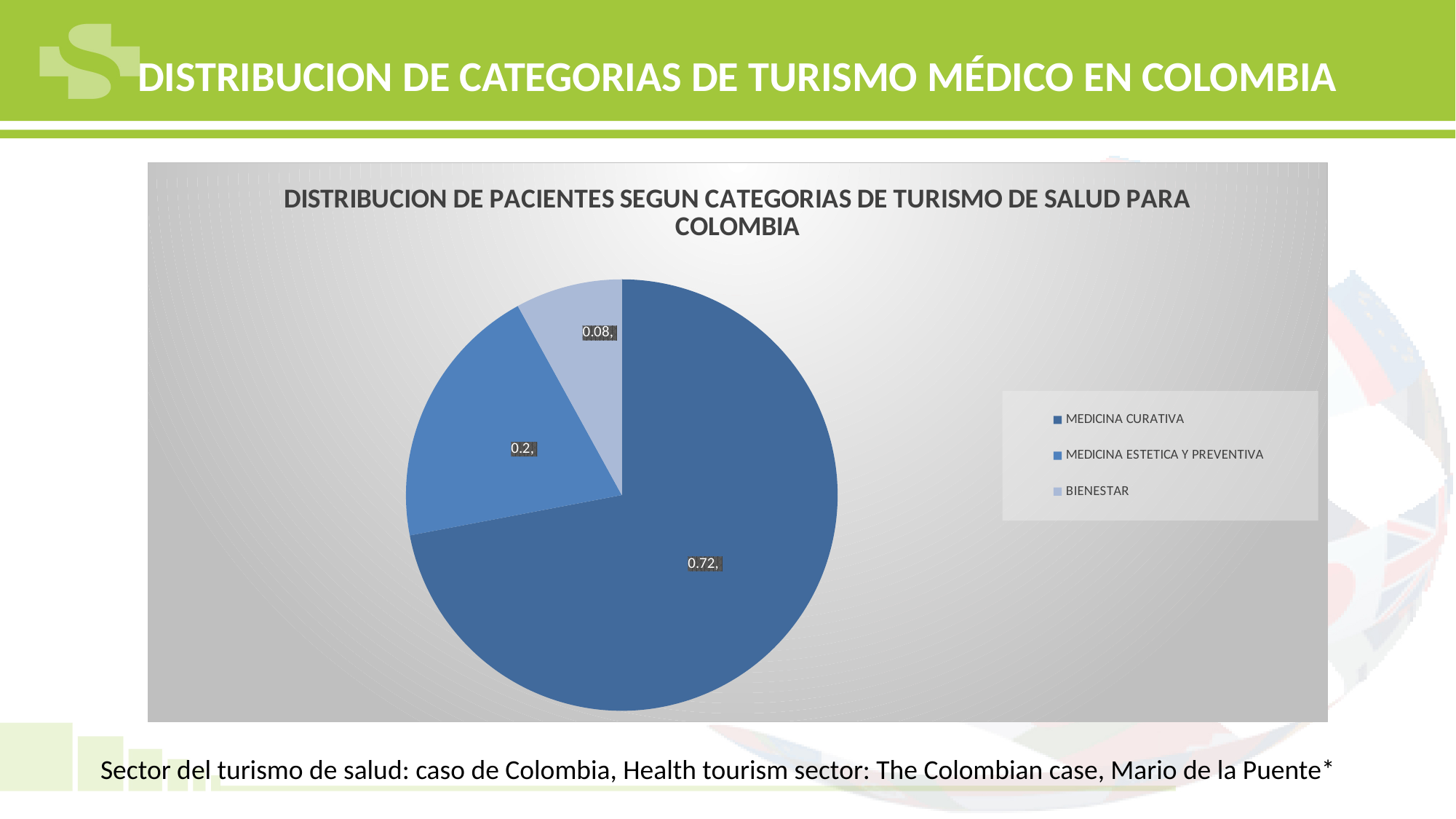
Which category has the largest slice of the pie? MEDICINA CURATIVA What is the difference between the values for MEDICINA CURATIVA and MEDICINA ESTETICA Y PREVENTIVA? 0.52 How many categories does the pie chart show? 3 What is the title of the chart? DISTRIBUCION DE PACIENTES SEGUN CATEGORIAS DE TURISMO DE SALUD PARA COLOMBIA Which legend entry is listed last? BIENESTAR What is the value shown for MEDICINA ESTETICA Y PREVENTIVA? 0.2 Which category has the smallest slice of the pie? BIENESTAR What type of chart is shown on the slide? pie chart What is the value shown for BIENESTAR? 0.08 What is the difference between the values for MEDICINA ESTETICA Y PREVENTIVA and BIENESTAR? 0.12 Which is larger, the value for MEDICINA ESTETICA Y PREVENTIVA or the value for BIENESTAR? MEDICINA ESTETICA Y PREVENTIVA What is the value shown for MEDICINA CURATIVA? 0.72